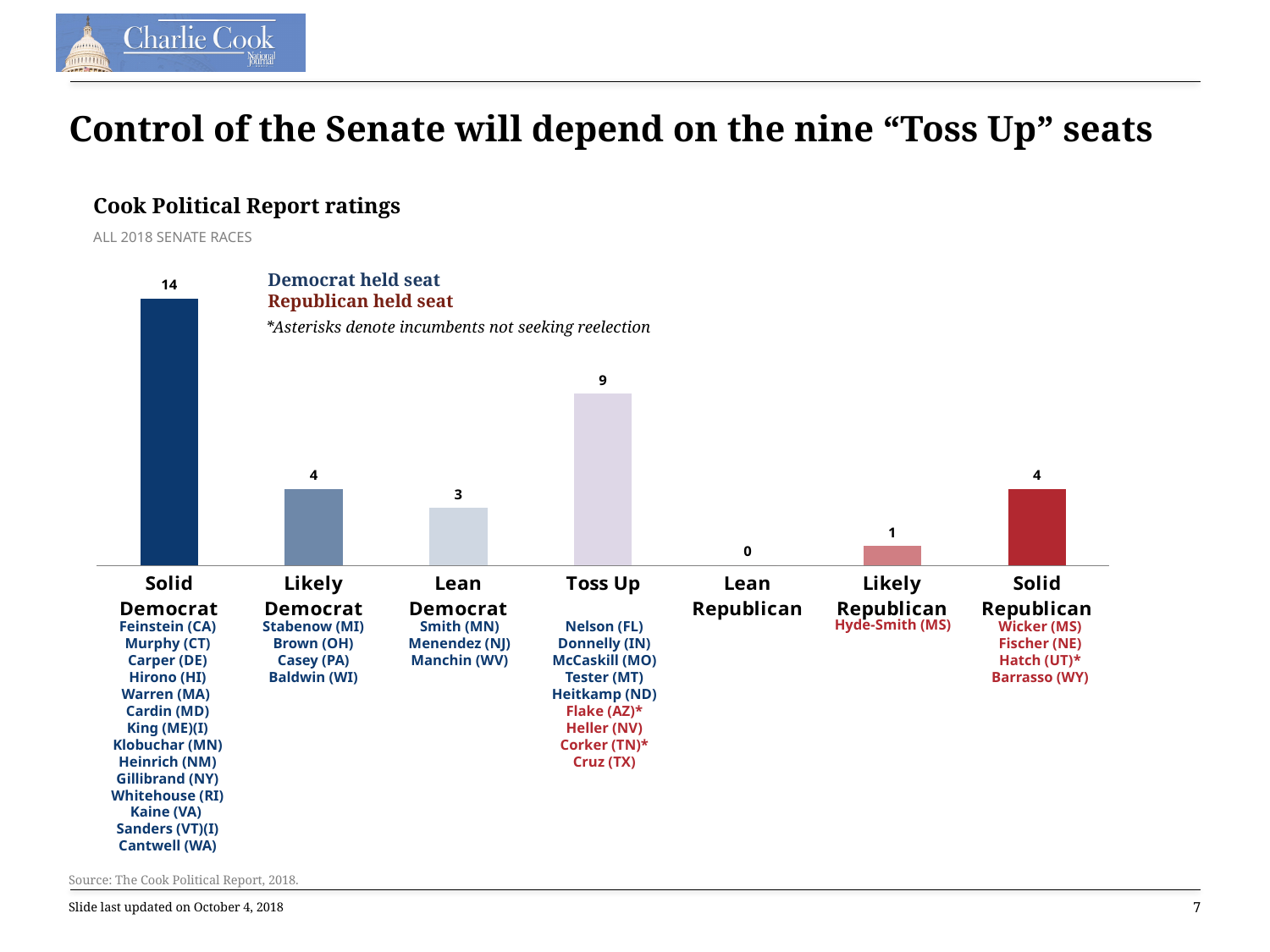
Which category has the lowest value? Lean Republican How many categories are shown on the x axis? 7 What is the value for Likely Republican? 1 Which is larger, Likely Democrat or Lean Democrat? Likely Democrat What is the title of the chart? Cook Political Report ratings What is the value for Toss Up? 9 Which category has the highest value? Solid Democrat What is the difference between Toss Up and Likely Democrat? 5 What kind of chart is this? Bar chart What is the value for Lean Republican? 0 What is the value for Solid Democrat? 14 What is the difference between Solid Democrat and Solid Republican? 10